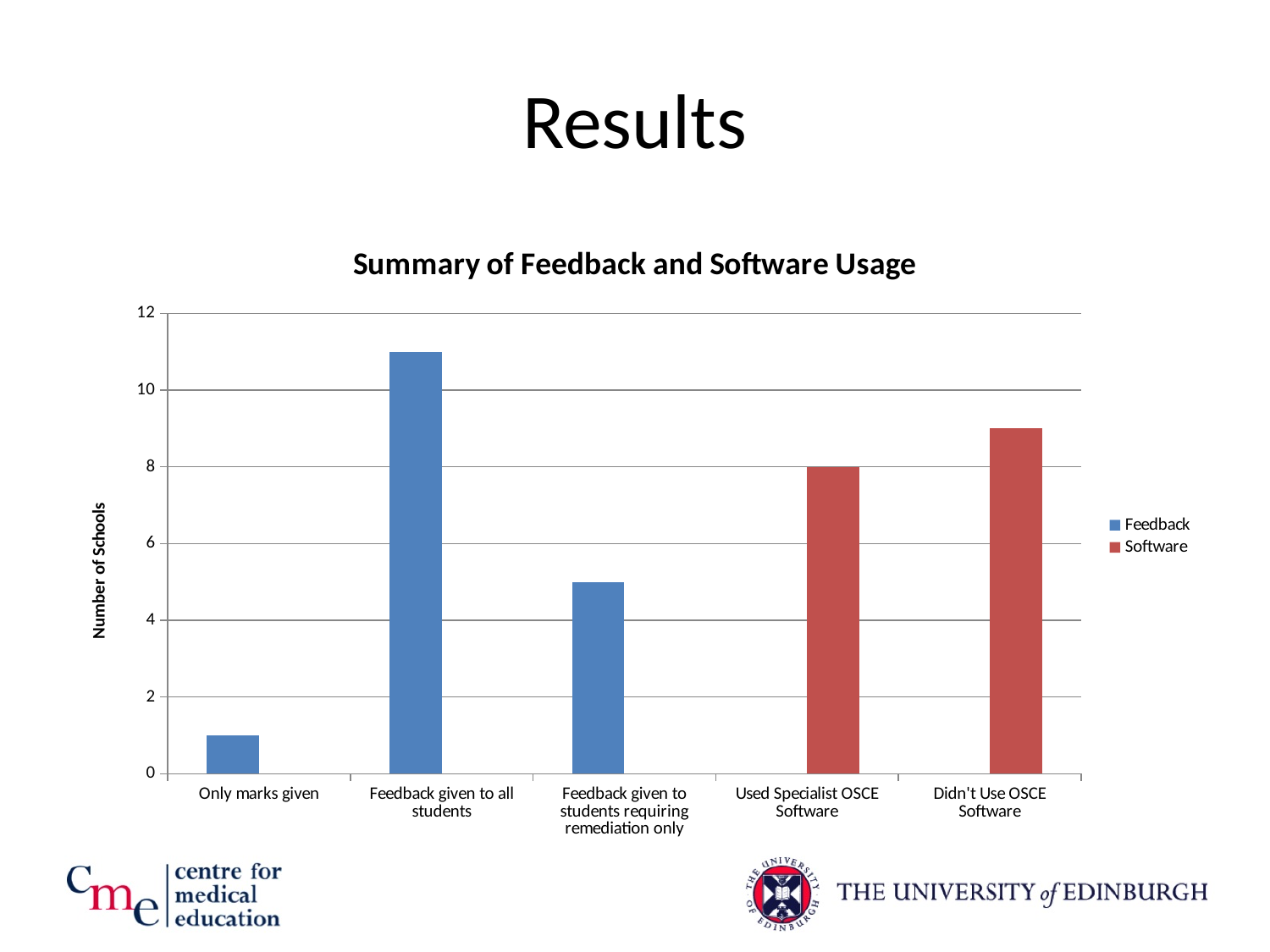
Which is larger, the value for Feedback given to all students or the value for Didn't Use OSCE Software? Feedback given to all students What kind of chart is shown? bar chart Which category has the lowest value? Only marks given How many categories are shown on the x axis? 5 Is the value for Feedback given to students requiring remediation only greater or less than 4? greater Is the value for Feedback given to all students greater or less than 10? greater Which category has the highest value? Feedback given to all students What is the value for Used Specialist OSCE Software? 8 What is the title of the chart? Summary of Feedback and Software Usage Is the value for Didn't Use OSCE Software greater or less than 10? less How many series does the legend list? 2